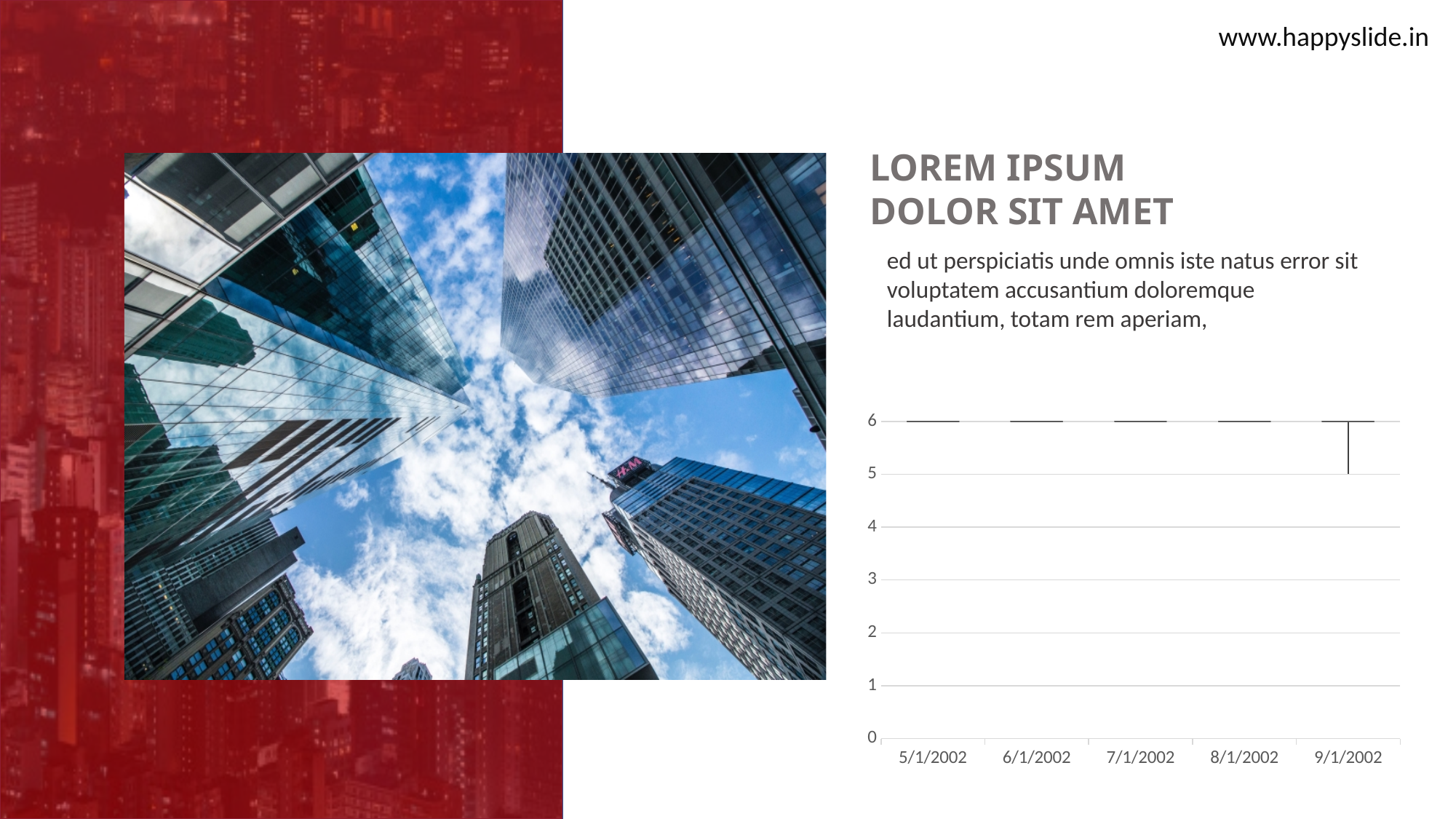
Which date on the chart has a vertical line extending below the 6 gridline? 9/1/2002 How many dates are shown on the x axis of the chart? 5 What is the lowest value labelled on the y axis of the chart? 0 Is the lowest point of the vertical line at 9/1/2002 greater or less than 4? greater What is the highest value labelled on the y axis of the chart? 6 Is the horizontal mark at 5/1/2002 greater or less than 3? greater Is the horizontal mark at 7/1/2002 greater or less than 5? greater Does the chart show a legend? No What is the last date shown on the x axis of the chart? 9/1/2002 What is the first date shown on the x axis of the chart? 5/1/2002